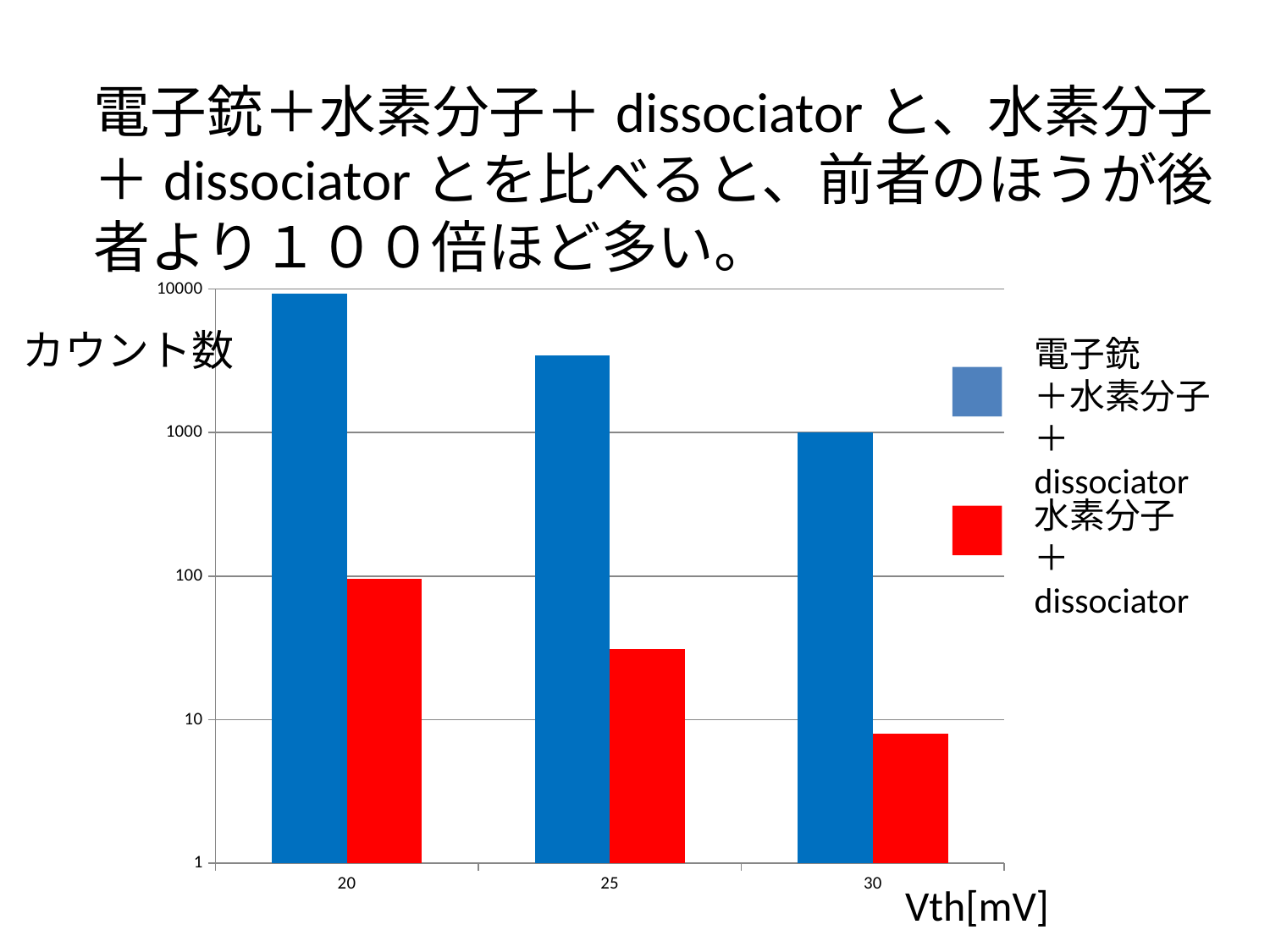
At which Vth[mV] value is the count for 水素分子＋dissociator lowest? 30 Do the counts for 電子銃＋水素分子＋dissociator rise or fall as Vth[mV] increases? fall Which colour represents the 水素分子＋dissociator series? red At which Vth[mV] value is the count for 電子銃＋水素分子＋dissociator highest? 20 How many Vth[mV] categories are shown on the x axis? 3 Is the count for 水素分子＋dissociator at Vth = 25 mV greater or less than 10? greater Is the count for 水素分子＋dissociator at Vth = 30 mV greater or less than 10? less Is the count for 電子銃＋水素分子＋dissociator at Vth = 20 mV greater or less than 1000? greater At Vth = 25 mV, which series has the larger count, 電子銃＋水素分子＋dissociator or 水素分子＋dissociator? 電子銃＋水素分子＋dissociator How many series does the legend list? 2 What is the label of the x axis? Vth[mV] What kind of chart is shown on the slide? bar chart